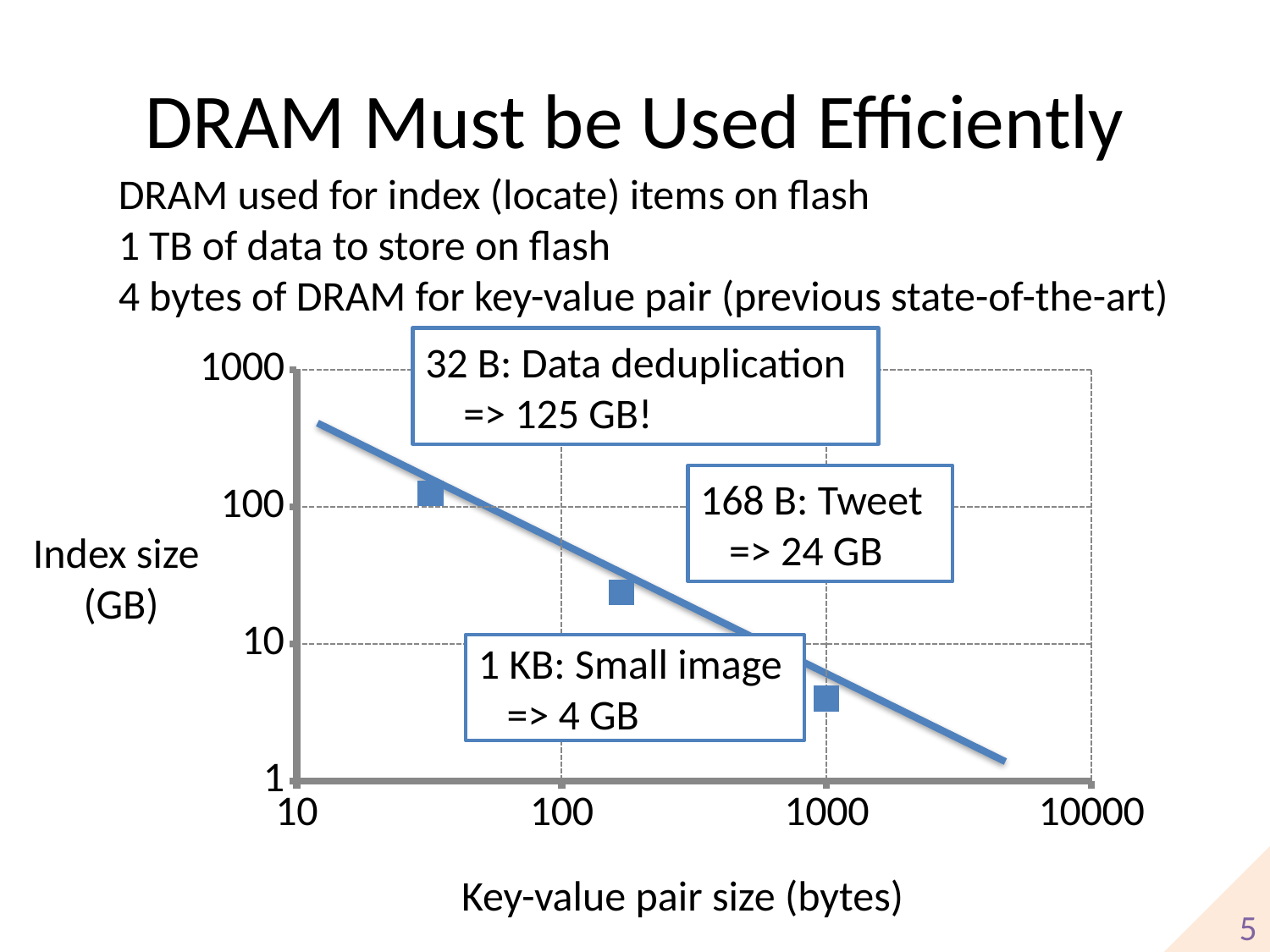
What index size does the chart give for a 1 KB key-value pair (small image)? 4 GB How many data points are plotted on the chart? 3 Does the index size rise or fall as the key-value pair size increases along the x axis? fall What index size does the chart give for a 168 B key-value pair (tweet)? 24 GB Which has a larger index size, the 168 B tweet or the 1 KB small image? 168 B tweet What index size does the chart give for a 32 B key-value pair (data deduplication)? 125 GB Which key-value pair size has the largest index size on the chart? 32 B What is the difference in index size between the 32 B and 168 B key-value pairs? 101 GB What is the label of the x axis of the chart? Key-value pair size (bytes) What is the difference in index size between the 168 B and 1 KB key-value pairs? 20 GB Which key-value pair size has the smallest index size on the chart? 1 KB Is the index size for the 1 KB key-value pair greater or less than 10 GB? less